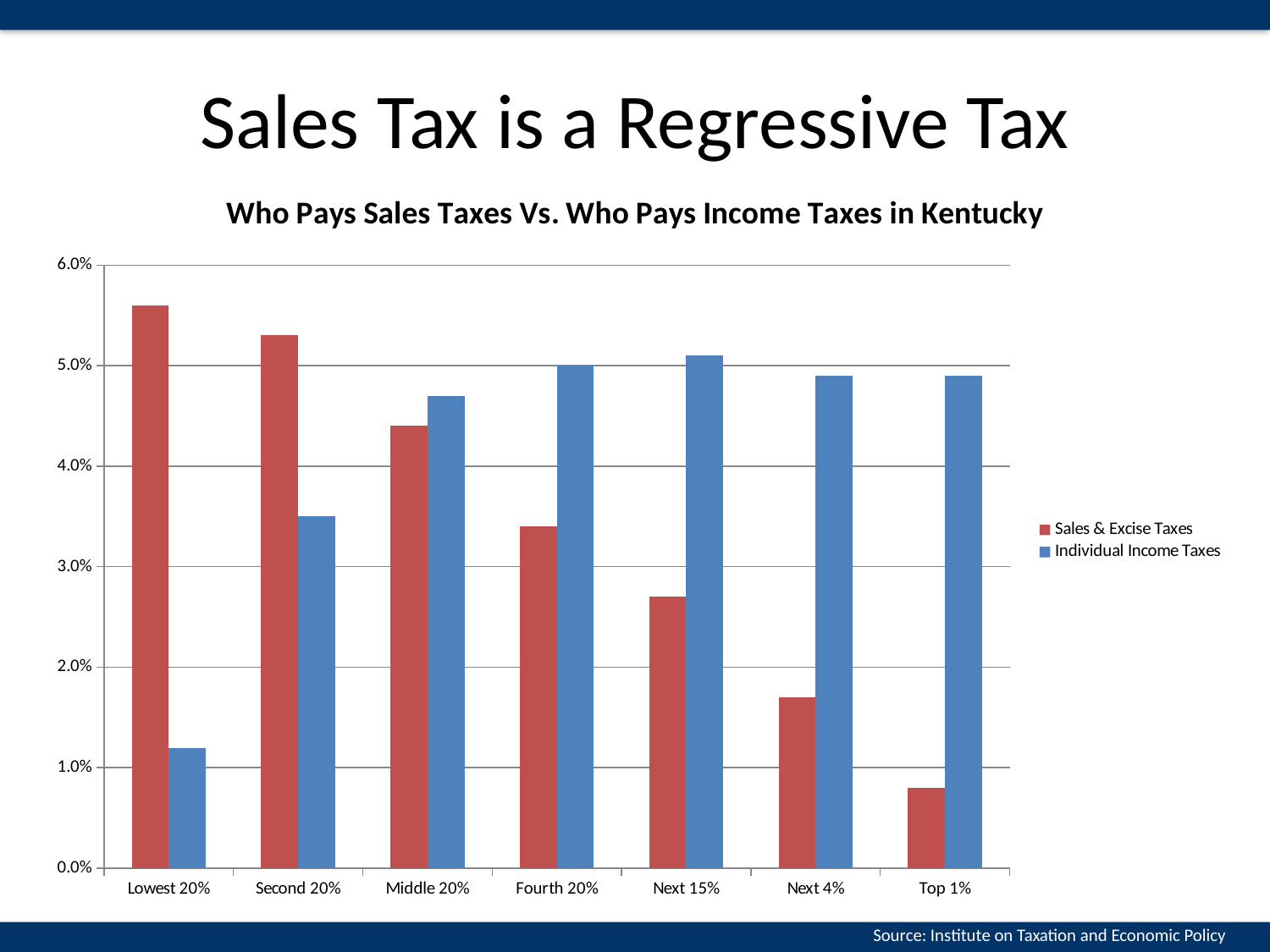
How many series does the legend list? 2 Is the Sales & Excise Taxes value for Top 1% greater or less than 1.0%? less Is the Individual Income Taxes value for Lowest 20% greater or less than 2.0%? less What colour are the Individual Income Taxes bars? blue Which income group has the highest value for Sales & Excise Taxes? Lowest 20% How many income groups are shown on the x axis? 7 Which income group has the lowest value for Sales & Excise Taxes? Top 1% Which income group has the lowest value for Individual Income Taxes? Lowest 20% For the Next 15% group, which is larger: Sales & Excise Taxes or Individual Income Taxes? Individual Income Taxes What type of chart is shown on the slide? bar chart Is the Sales & Excise Taxes value for Lowest 20% greater or less than 5.0%? greater Do the Sales & Excise Taxes values rise or fall moving from Lowest 20% to Top 1% along the x axis? fall